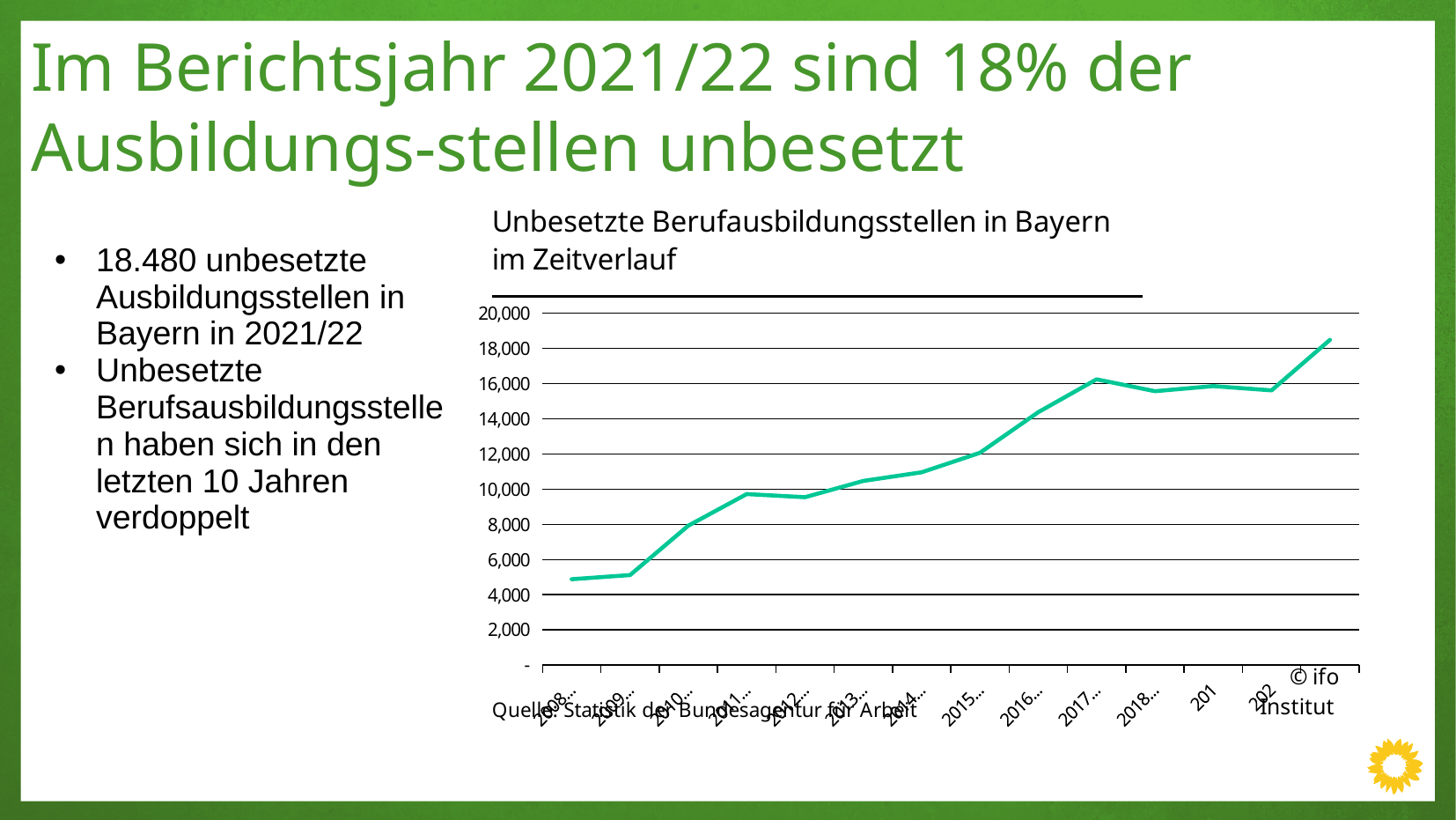
What is the title of the chart? Unbesetzte Berufausbildungsstellen in Bayern im Zeitverlauf How many data points are plotted on the line? 14 Which is larger, the value for 2010 or the value for 2016? 2016 Is the value for 2017 greater or less than 14,000? greater Is the value for 2015 greater or less than 10,000? greater Is the value for 2008 greater or less than 6,000? less What source is cited below the chart? Statistik der Bundesagentur für Arbeit What kind of chart is shown on the slide? line chart Which is larger, the value for 2012 or the value for 2017? 2017 Overall, do the values in the chart rise or fall from left to right along the x axis? rise